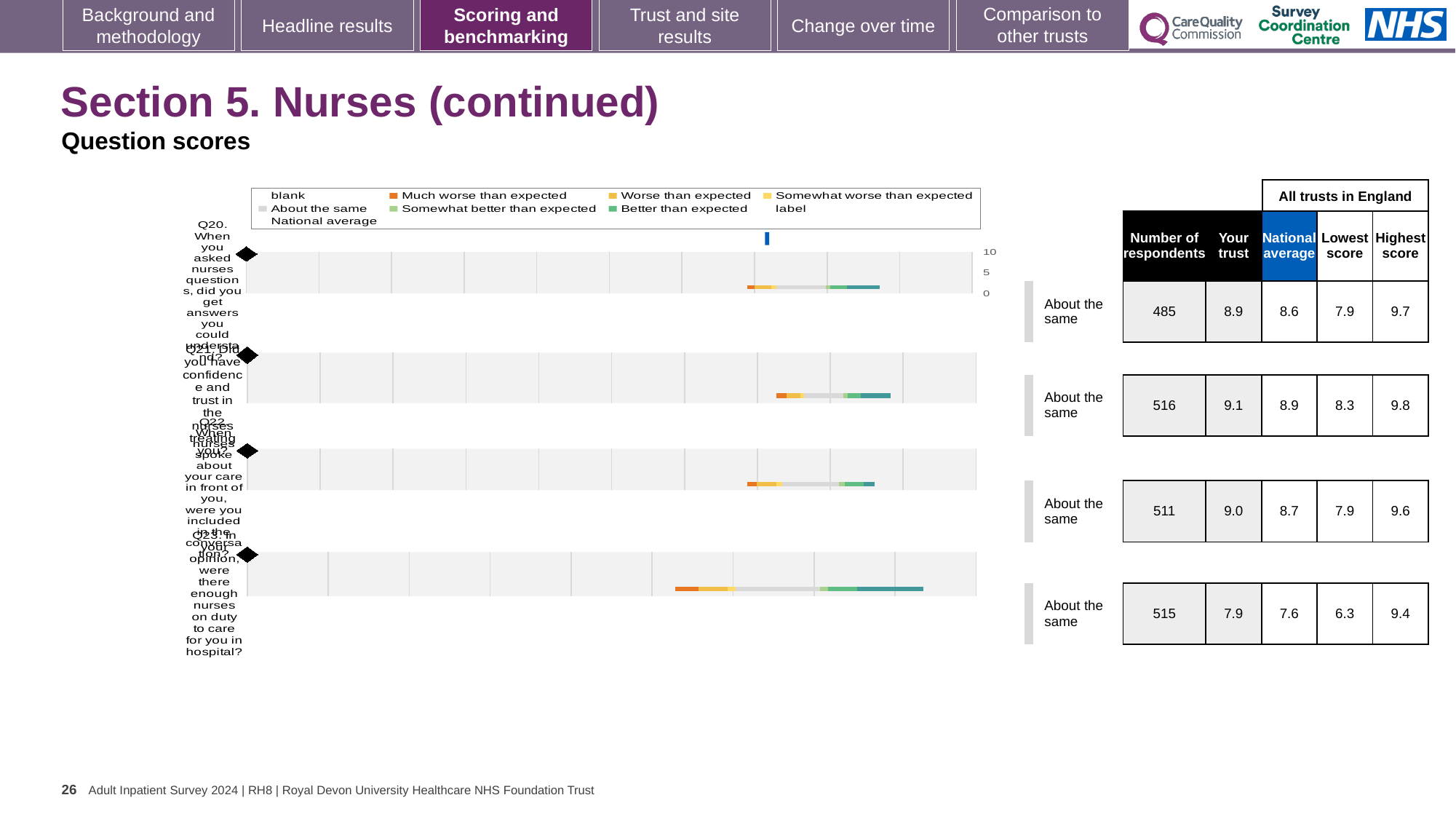
Which question has the lowest 'Your trust' score on this slide? Q23 In the chart legend, which colour represents 'Much worse than expected'? orange In the chart legend, which colour represents 'About the same'? grey What is the 'Your trust' score for Q20 (When you asked nurses questions, did you get answers you could understand)? 8.9 What is the lowest score among all trusts in England for Q23 (In your opinion, were there enough nurses on duty to care for you in hospital)? 6.3 What kind of chart is used to show the benchmarking results for each question on this slide? bar chart How many question charts (Q20 to Q23) are shown on the slide? 4 Which question has the highest 'Your trust' score on this slide? Q21 How many respondents answered Q22 (When nurses spoke about your care in front of you, were you included in the conversation)? 511 What is the national average score for Q21 (Did you have confidence and trust in the nurses treating you)? 8.9 For Q22, which is larger: the 'Your trust' score or the national average? Your trust For Q23, what is the difference between the 'Your trust' score and the national average? 0.3